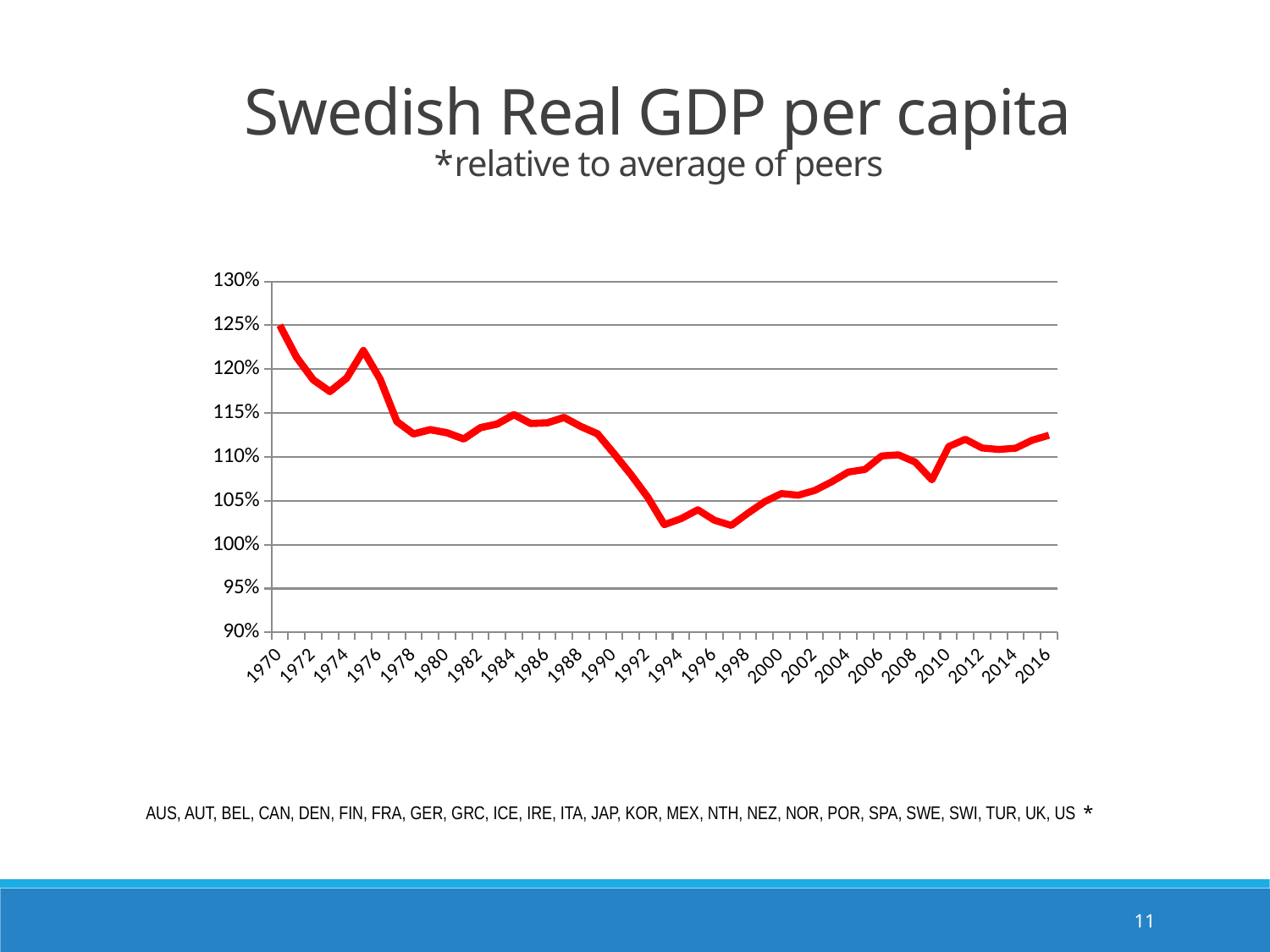
Does the line generally rise or fall between 1970 and 1993? fall Is the value for 1970 greater or less than 120%? greater Is the value for 2009 greater or less than 110%? less Is the value for 1993 greater or less than 105%? less What kind of chart is shown on the slide? line chart What is the title of the chart? Swedish Real GDP per capita In which year does the line reach its highest value? 1970 Which year has the larger value, 1970 or 2016? 1970 What colour is the plotted line? red Does the line generally rise or fall between 1997 and 2016? rise